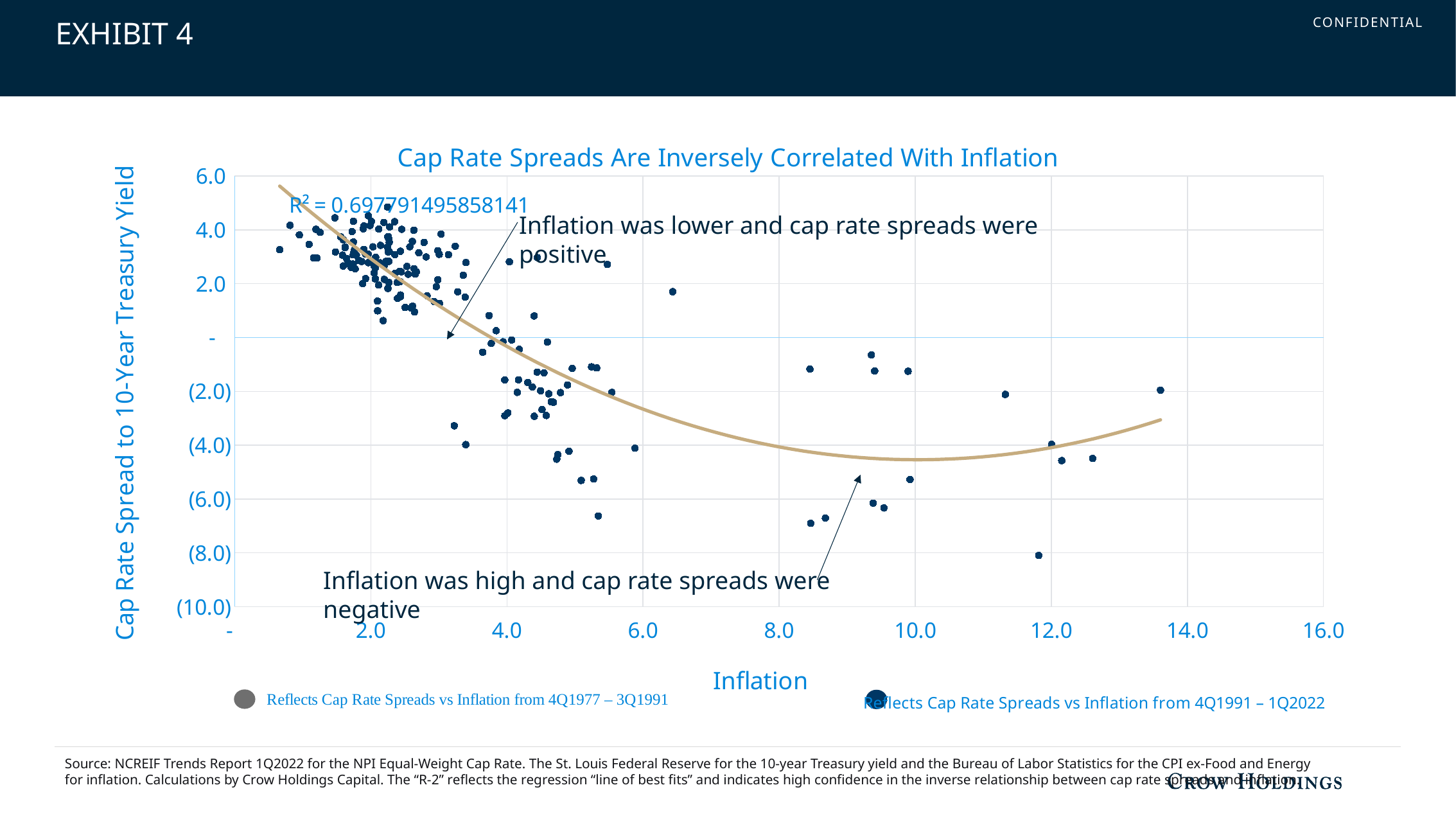
How many series does the legend list? 2 What is the title of the chart? Cap Rate Spreads Are Inversely Correlated With Inflation Is the cap rate spread of the lowest point on the chart greater or less than (6.0)? less What is the lowest value shown on the y axis? (10.0) Which has the larger cap rate spread: the point with the lowest inflation or the point with the highest inflation? The point with the lowest inflation As inflation increases along the x axis, do cap rate spreads generally rise or fall? Fall What is the highest value shown on the x axis? 16.0 Is the cap rate spread for the point with the highest inflation greater or less than 0? less What R² value is printed on the chart? R² = 0.697791495858141 Is the cap rate spread for the point with the lowest inflation greater or less than 2.0? greater What is the label of the x axis? Inflation What kind of chart is shown on the slide? Scatter chart